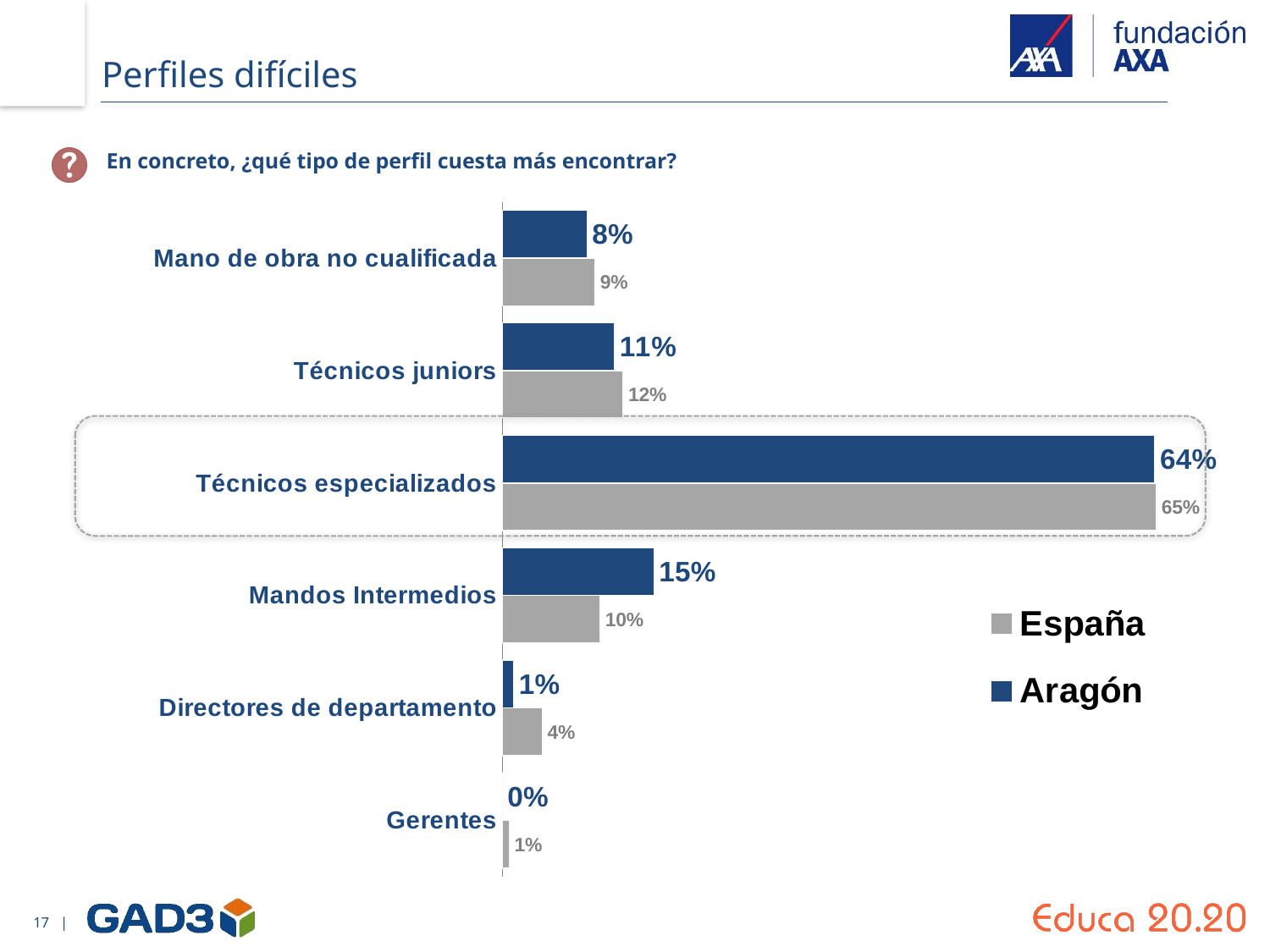
Which category has the highest value for Aragón? Técnicos especializados What kind of chart is shown on the slide? Bar chart How many series does the legend list? 2 What is the value for Aragón for Técnicos especializados? 64% What is the difference between the España values for Técnicos especializados and Técnicos juniors? 53% For Directores de departamento, which series has the larger value, España or Aragón? España How many categories are shown in the chart? 6 Which category has the lowest value for España? Gerentes What is the difference between the Aragón and España values for Mandos Intermedios? 5% What is the value for Aragón for Directores de departamento? 1% What is the value for España for Mandos Intermedios? 10% What is the value for España for Gerentes? 1%